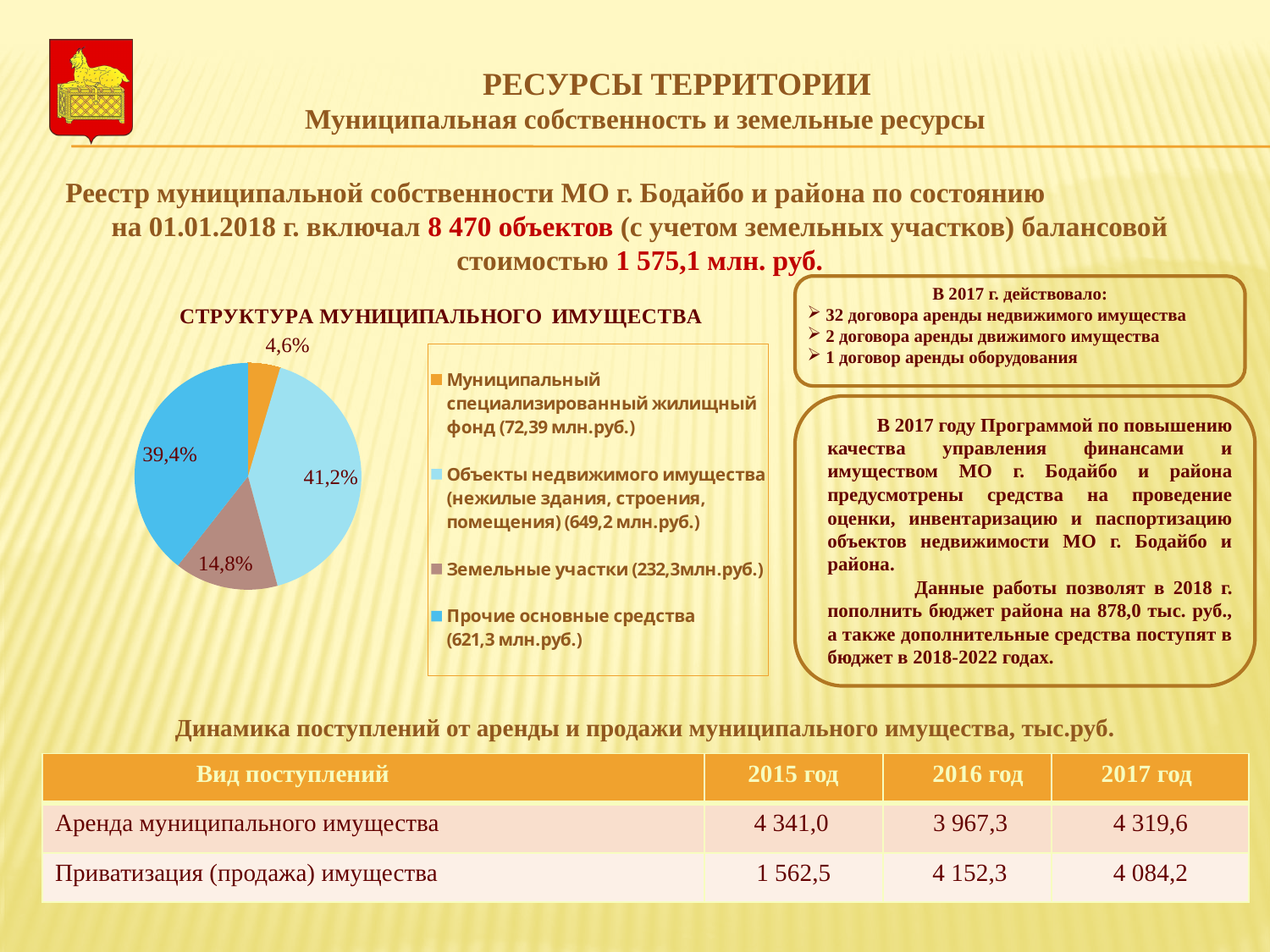
What share of the pie chart is labelled for "Муниципальный специализированный жилищный фонд"? 4,6% What colour is the slice for "Муниципальный специализированный жилищный фонд" in the pie chart? orange Which category has the largest slice in the pie chart? Объекты недвижимого имущества (нежилые здания, строения, помещения) What share of the pie chart is labelled for "Объекты недвижимого имущества (нежилые здания, строения, помещения)"? 41,2% According to the pie chart legend, what is the value in млн.руб. for "Земельные участки"? 232,3 млн.руб. How many slices does the pie chart have? 4 What share of the pie chart is labelled for "Прочие основные средства"? 39,4% Which category has the smallest slice in the pie chart? Муниципальный специализированный жилищный фонд What kind of chart is shown under the heading "СТРУКТУРА МУНИЦИПАЛЬНОГО ИМУЩЕСТВА"? pie chart In the pie chart, which is larger: the share for "Земельные участки" or the share for "Прочие основные средства"? Прочие основные средства What is the difference in percentage points between the "Объекты недвижимого имущества" slice and the "Прочие основные средства" slice? 1,8